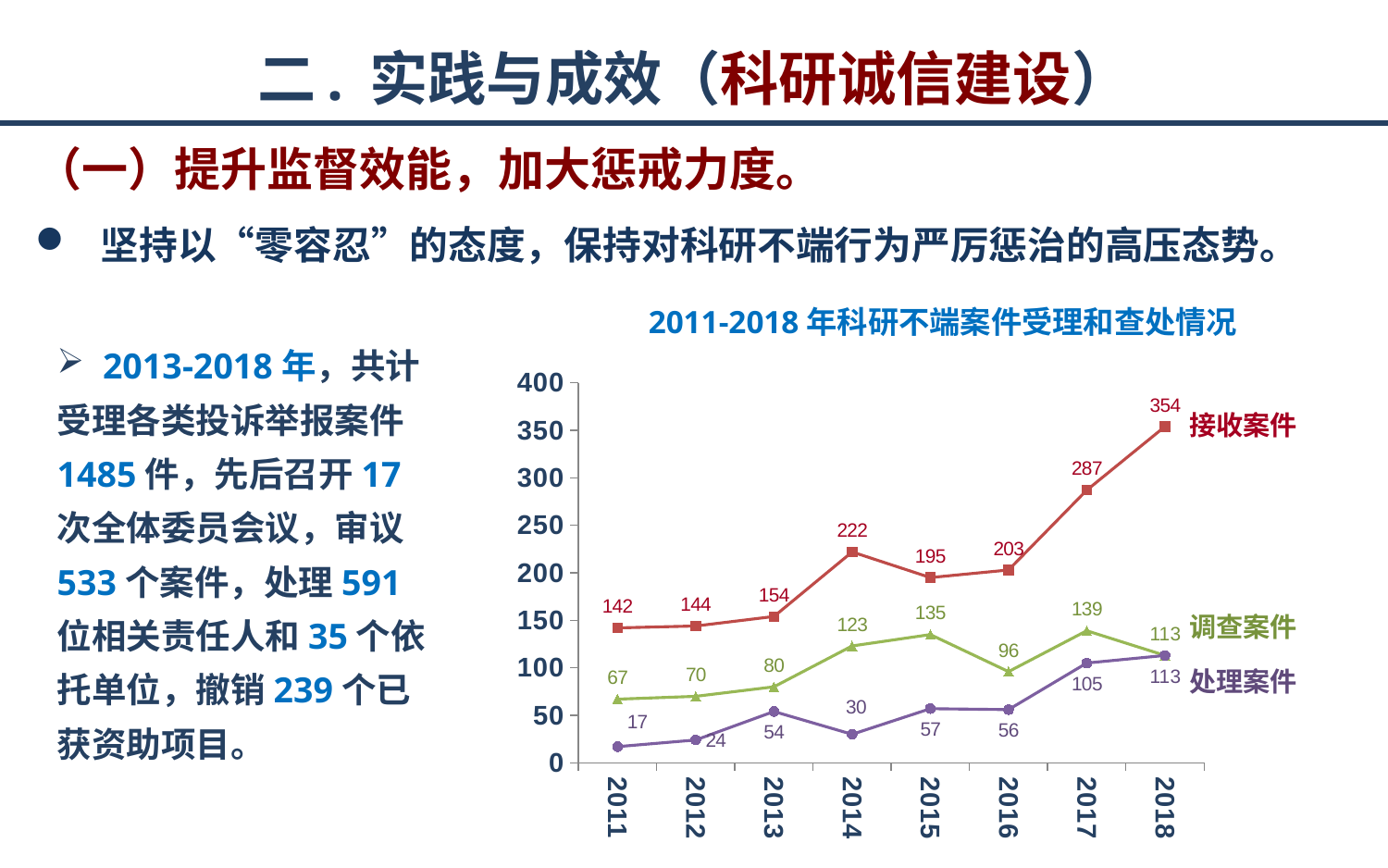
What is the value of 接收案件 in 2018? 354 What is the value of 调查案件 in 2015? 135 What is the value of 处理案件 in 2014? 30 Does 接收案件 generally rise or fall from 2011 to 2018? rise In which year is 处理案件 lowest? 2011 How many series does the chart show? 3 Which is larger: 调查案件 in 2016 or 调查案件 in 2017? 2017 In which year is 接收案件 highest? 2018 What is the difference between 接收案件 in 2018 and 2017? 67 What is the title of the chart? 2011-2018 年科研不端案件受理和查处情况 How many years are plotted on the x axis? 8 What type of chart is shown on the slide? line chart